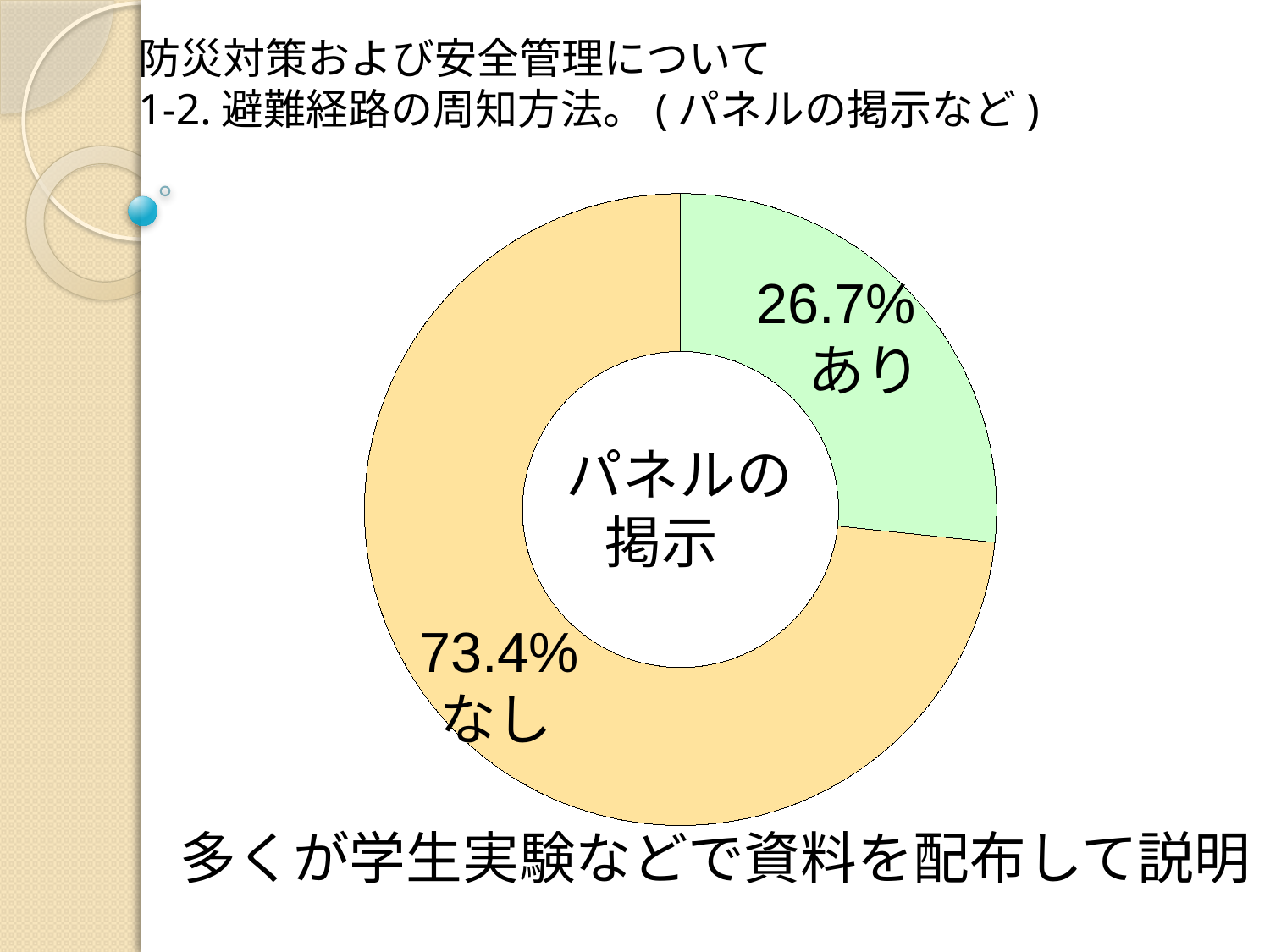
What percentage is shown for あり (panel displayed)? 26.7% What text is written in the centre of the doughnut chart? パネルの掲示 What is the difference in percentage points between なし and あり? 46.7 What percentage is shown for なし (no panel displayed)? 73.4% Which category has the larger share, あり or なし? なし What colour is the あり segment of the chart? Light green Which category has the smallest share in the chart? あり What kind of chart is shown on the slide? Doughnut chart How many categories are shown in the chart? 2 Which category has the largest share in the chart? なし